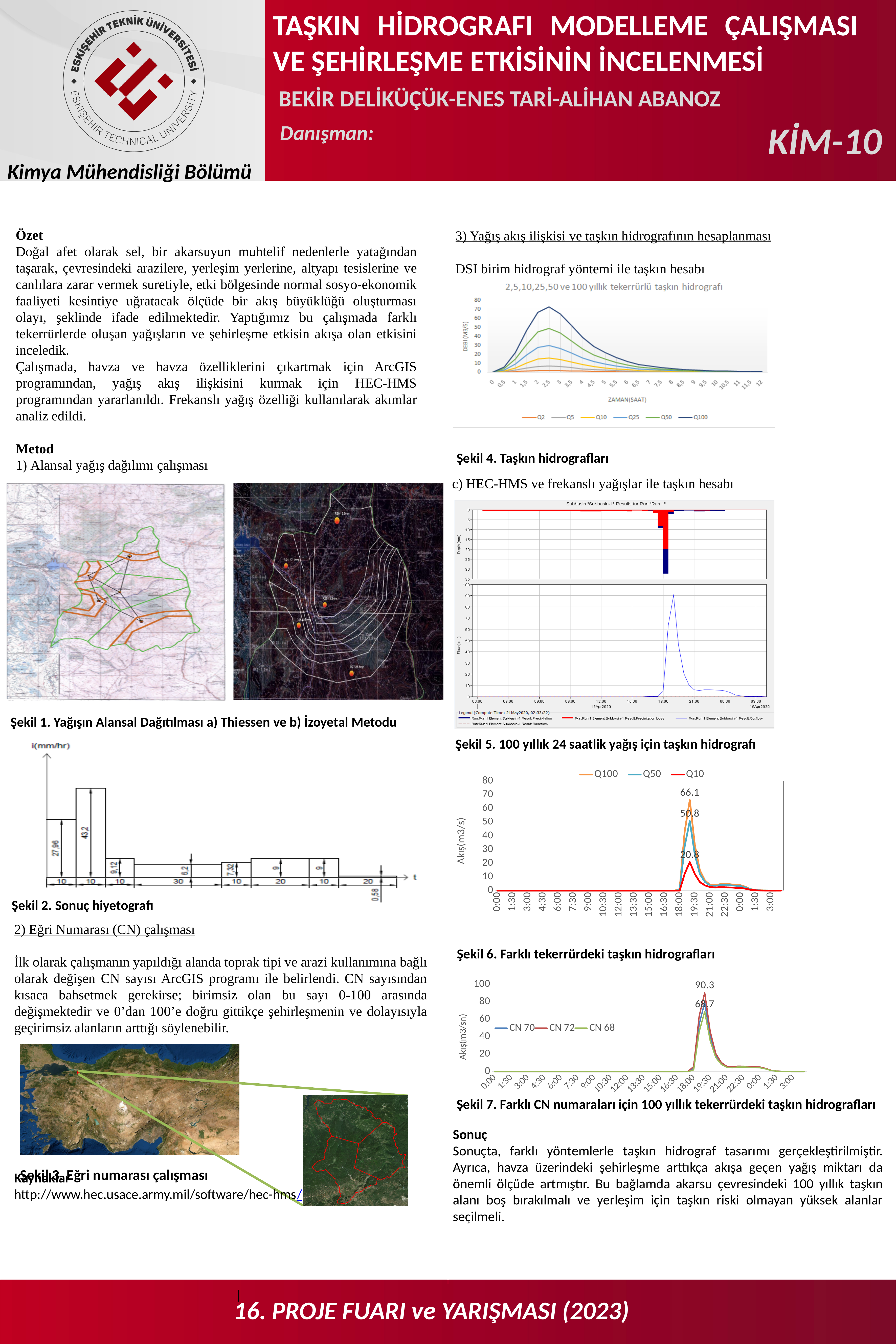
In the hyetograph 'Şekil 2. Sonuç hiyetografı', what is the largest intensity value labelled on a bar? 43.2 In the chart titled 'Şekil 6. Farklı tekerrürdeki taşkın hidrografları', how many series does the legend list? 3 In the chart titled 'Şekil 6. Farklı tekerrürdeki taşkın hidrografları', what is the peak value labelled for the Q10 series? 20.8 In the chart titled 'Şekil 6. Farklı tekerrürdeki taşkın hidrografları', what is the difference between the Q100 peak and the Q50 peak? 15.3 In the chart titled '2,5,10,25,50 ve 100 yıllık tekerrürlü taşkın hidrografı' (Şekil 4), what kind of chart is it? line chart In the chart titled 'Şekil 7. Farklı CN numaraları için 100 yıllık tekerrürdeki taşkın hidrografları', how many series does the legend list? 3 In the chart titled 'Şekil 6. Farklı tekerrürdeki taşkın hidrografları', what is the peak value labelled for the Q100 series? 66.1 In the chart titled 'Şekil 7. Farklı CN numaraları için 100 yıllık tekerrürdeki taşkın hidrografları', what is the highest peak value labelled? 90.3 In the chart titled '2,5,10,25,50 ve 100 yıllık tekerrürlü taşkın hidrografı' (Şekil 4), is the peak value of the Q100 series greater or less than 60? greater In the chart titled '2,5,10,25,50 ve 100 yıllık tekerrürlü taşkın hidrografı' (Şekil 4), how many series does the legend list? 6 In the chart titled 'Şekil 6. Farklı tekerrürdeki taşkın hidrografları', which series has the highest peak? Q100 In the chart titled 'Şekil 6. Farklı tekerrürdeki taşkın hidrografları', what is the peak value labelled for the Q50 series? 50.8